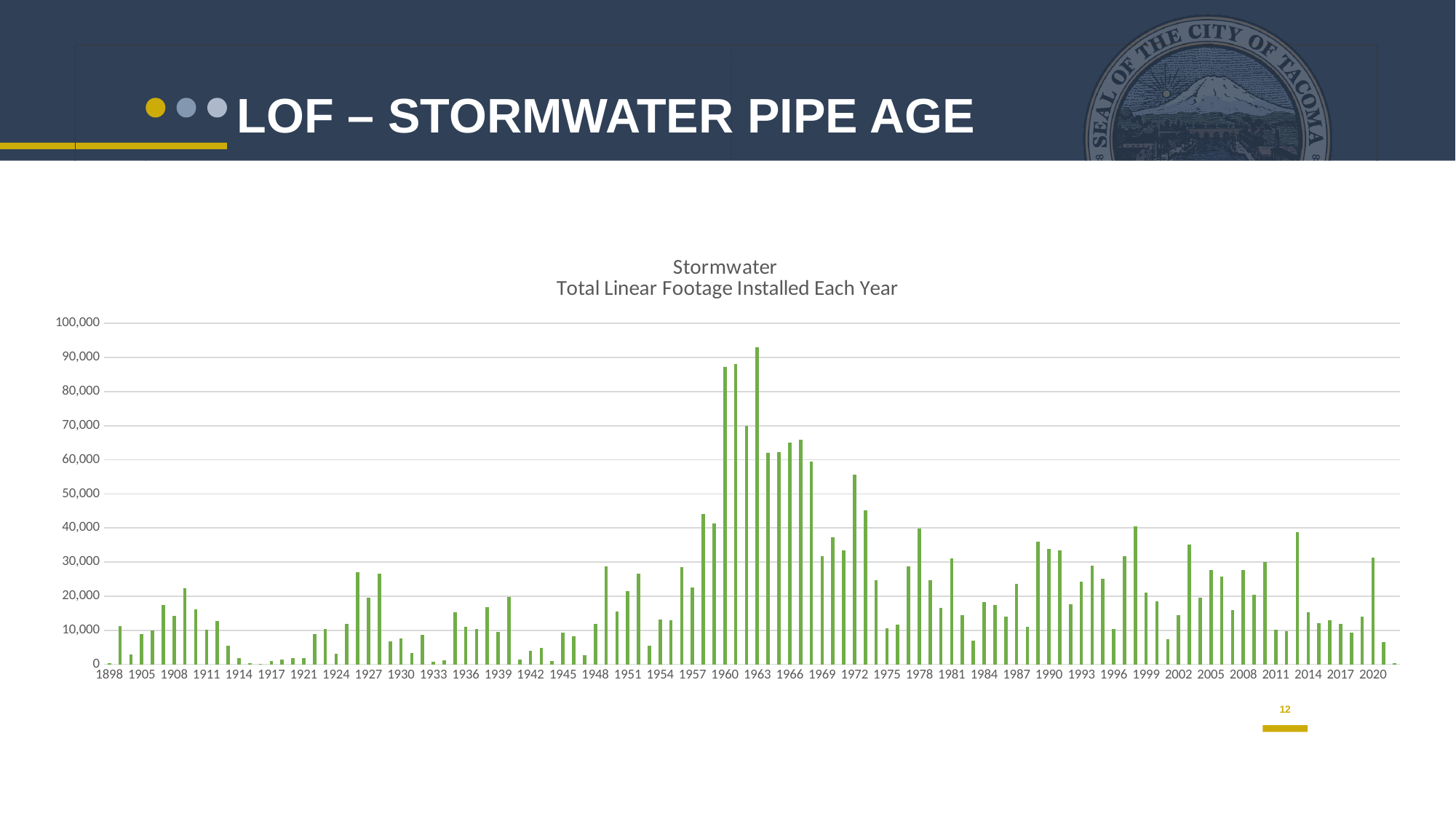
Is the value for 1960 greater or less than 80,000? greater Which year has the highest total linear footage installed? 1963 Is the value for 1972 greater or less than 50,000? greater Which year has the larger value, 1960 or 1990? 1960 Is the value for 1963 greater or less than 80,000? greater Which year has the larger value, 1972 or 1975? 1972 What kind of chart is shown on the slide? bar chart Do the values generally rise or fall from 1963 to 1969? fall What is the title of the chart? Stormwater Total Linear Footage Installed Each Year